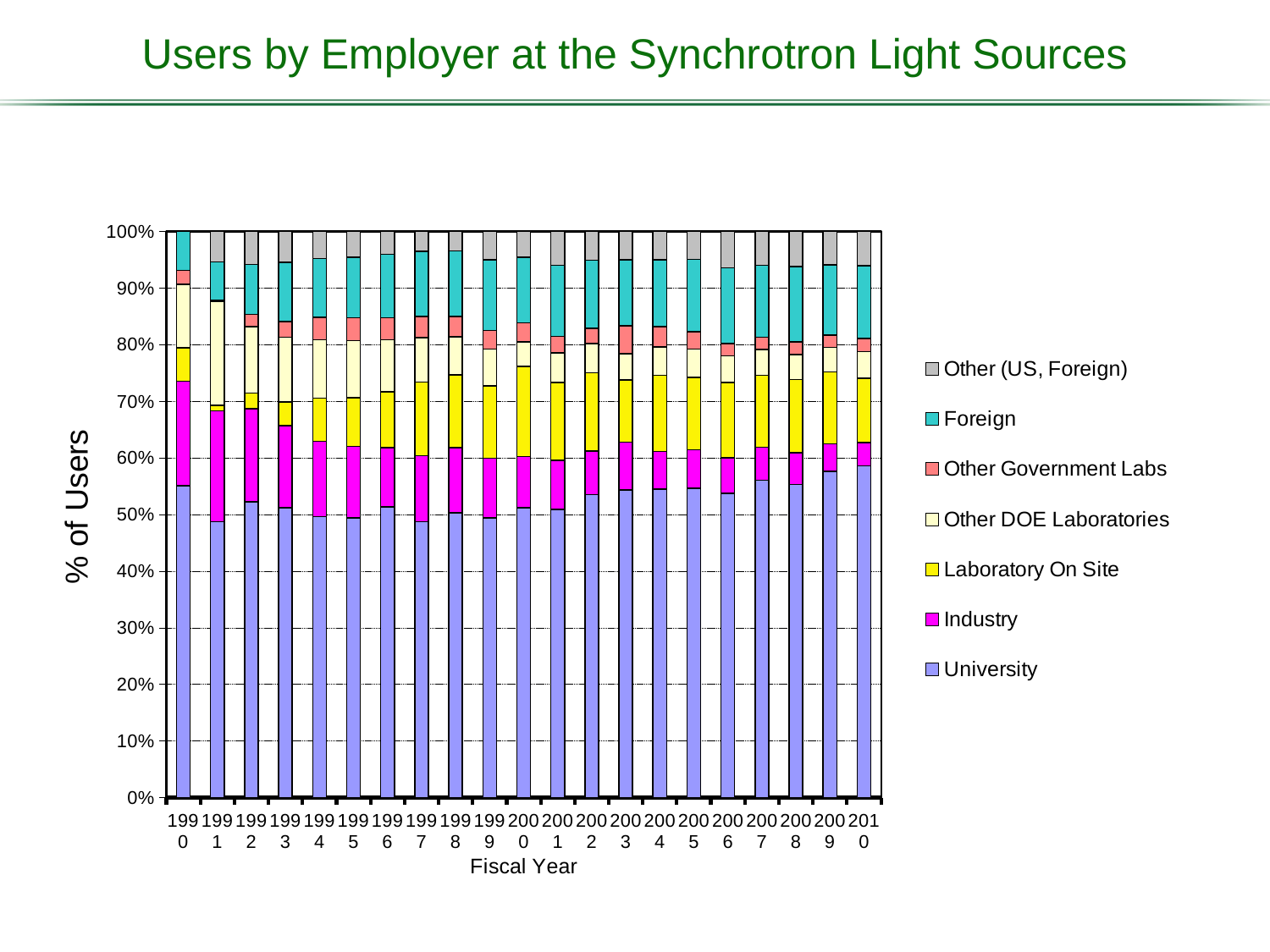
How many series does the legend list? 7 Is the University share of users in fiscal year 2009 greater or less than 50%? greater How many fiscal years are plotted along the x axis? 21 What is the title of the chart? Users by Employer at the Synchrotron Light Sources Which fiscal year has the larger University share of users, 1997 or 2008? 2008 Is the University share of users in fiscal year 2010 greater or less than 60%? less Is the University share of users in fiscal year 2010 greater or less than 50%? greater What is the label on the x axis? Fiscal Year What kind of chart is shown on the slide? stacked bar chart Which fiscal year has the larger University share of users, 1991 or 2010? 2010